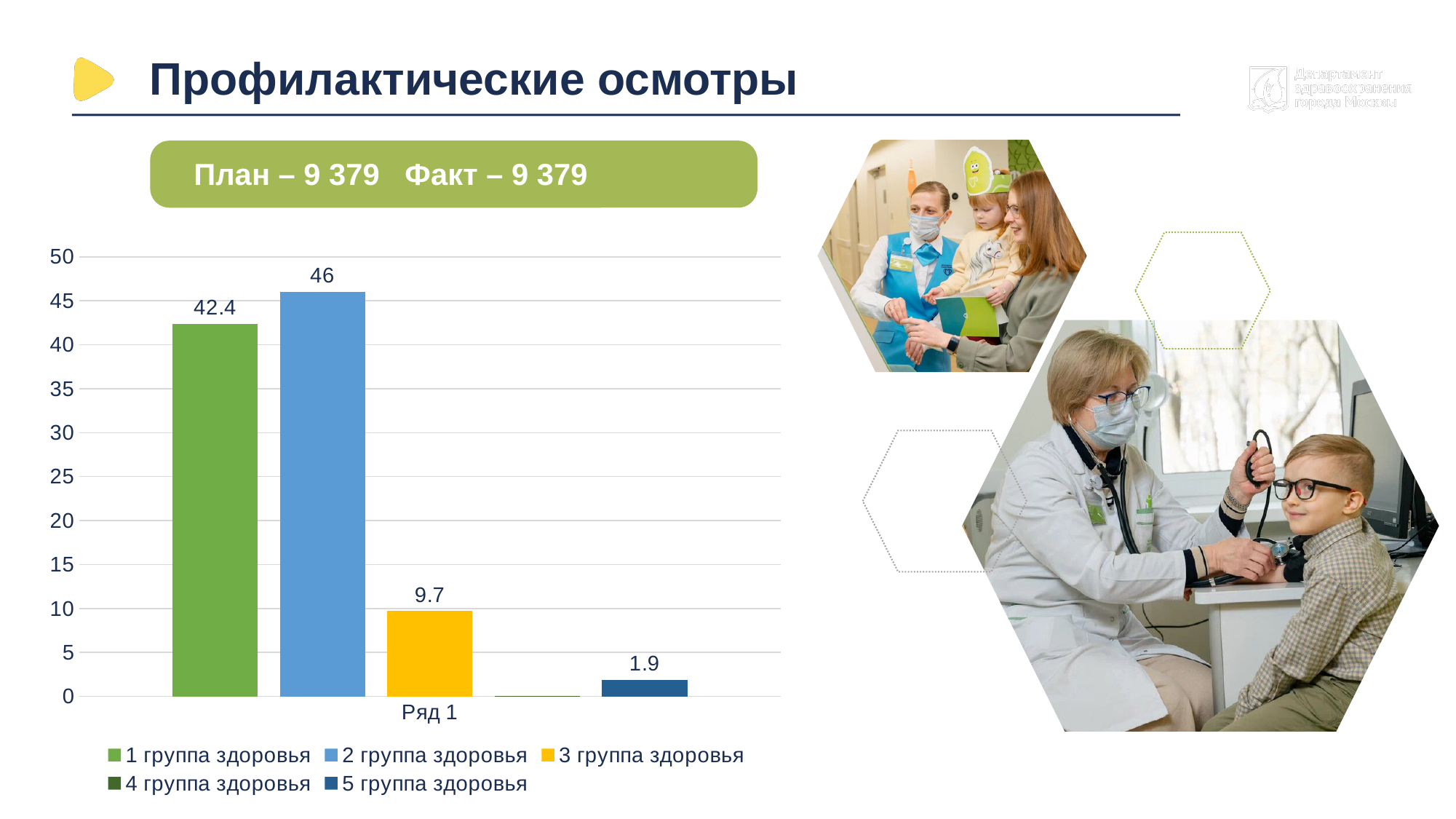
What kind of chart is shown on the slide? bar chart What is the difference between the values for 2 группа здоровья and 1 группа здоровья? 3.6 What is the value for 3 группа здоровья? 9.7 Which is larger, the value for 3 группа здоровья or 5 группа здоровья? 3 группа здоровья How many series does the legend list? 5 Which health group has the lowest value? 4 группа здоровья What is the value for 1 группа здоровья? 42.4 What is the value for 2 группа здоровья? 46 Is the value for 4 группа здоровья greater or less than 5? less What is the value for 5 группа здоровья? 1.9 Which health group has the highest value? 2 группа здоровья What colour is the bar for 3 группа здоровья? yellow